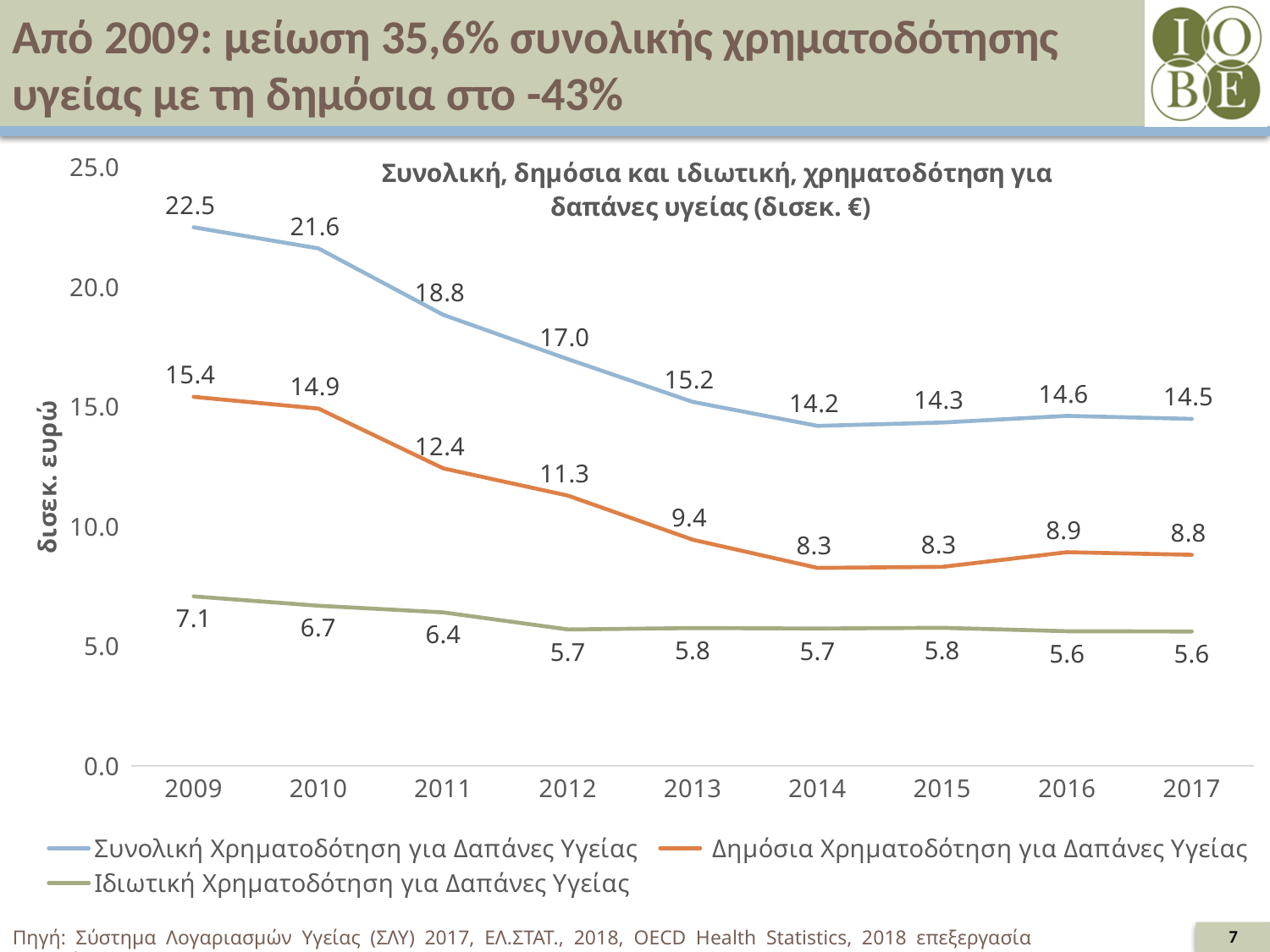
What is the difference between Συνολική Χρηματοδότηση για Δαπάνες Υγείας in 2009 and in 2017? 8.0 In which year is Συνολική Χρηματοδότηση για Δαπάνες Υγείας lowest? 2014 What kind of chart is shown on the slide? line chart Is the value of Δημόσια Χρηματοδότηση για Δαπάνες Υγείας in 2012 greater or less than 10.0? greater What is the value of Συνολική Χρηματοδότηση για Δαπάνες Υγείας in 2009? 22.5 Which is larger: Δημόσια Χρηματοδότηση για Δαπάνες Υγείας in 2016 or in 2017? 2016 Does Ιδιωτική Χρηματοδότηση για Δαπάνες Υγείας rise or fall from 2009 to 2017? fall What is the value of Ιδιωτική Χρηματοδότηση για Δαπάνες Υγείας in 2011? 6.4 What is the value of Δημόσια Χρηματοδότηση για Δαπάνες Υγείας in 2013? 9.4 How many series does the legend list? 3 In which year is Δημόσια Χρηματοδότηση για Δαπάνες Υγείας highest? 2009 How many years are shown on the x axis? 9